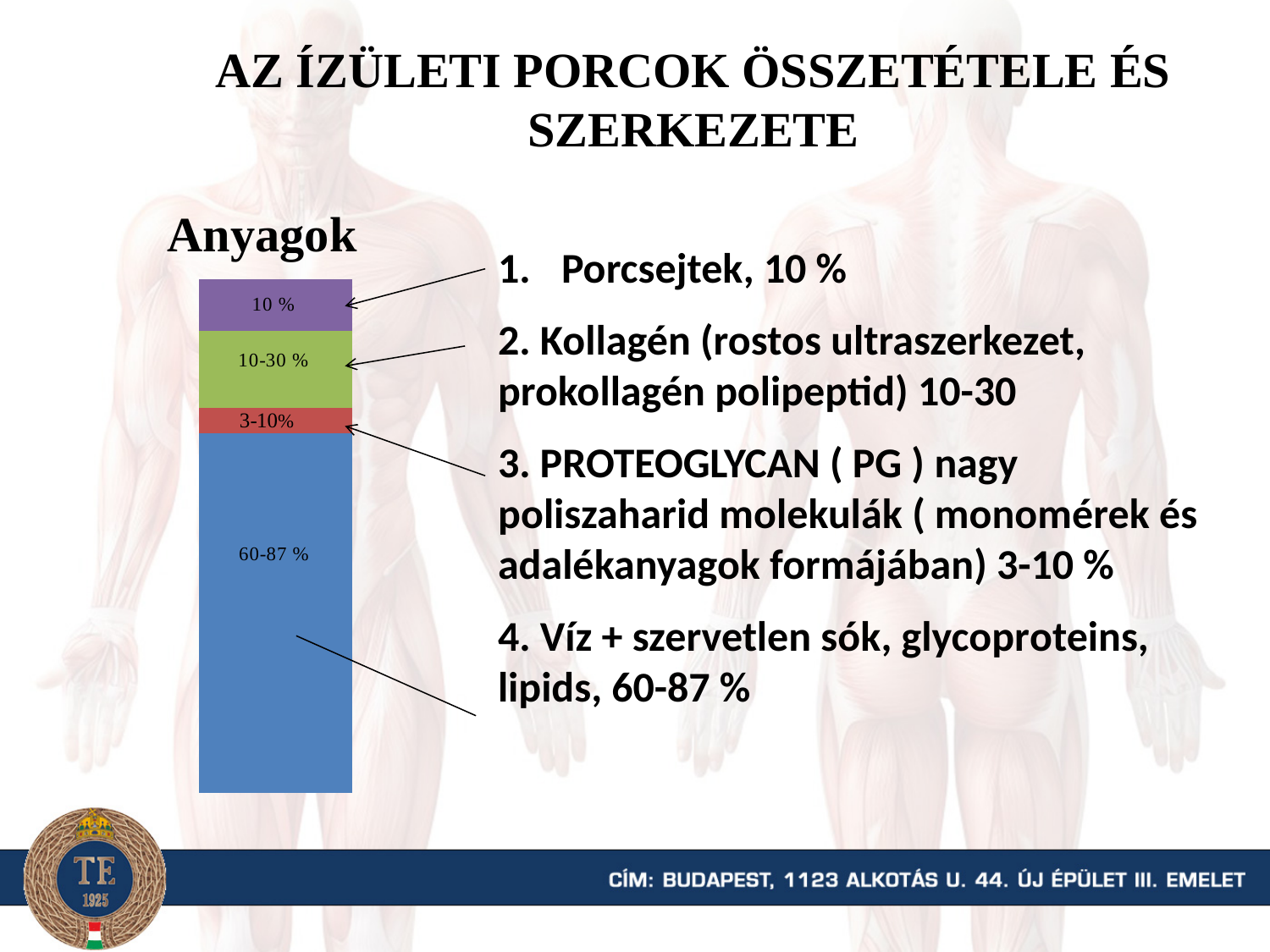
What is the title of the chart? Anyagok Which is larger, the blue segment or the green segment? The blue segment What value is printed on the red segment of the bar? 3-10% How many segments does the stacked bar contain? 4 What value is printed on the purple segment at the top of the bar? 10 % What value is printed on the green segment of the bar? 10-30 % Which segment of the bar is the largest? The blue segment (60-87 %) What colour is the segment labelled 60-87 %? Blue What kind of chart is shown on the slide? Stacked bar chart Which is larger, the green segment or the red segment? The green segment Which segment of the bar is the smallest? The red segment (3-10%) What value is printed on the blue segment at the bottom of the bar? 60-87 %